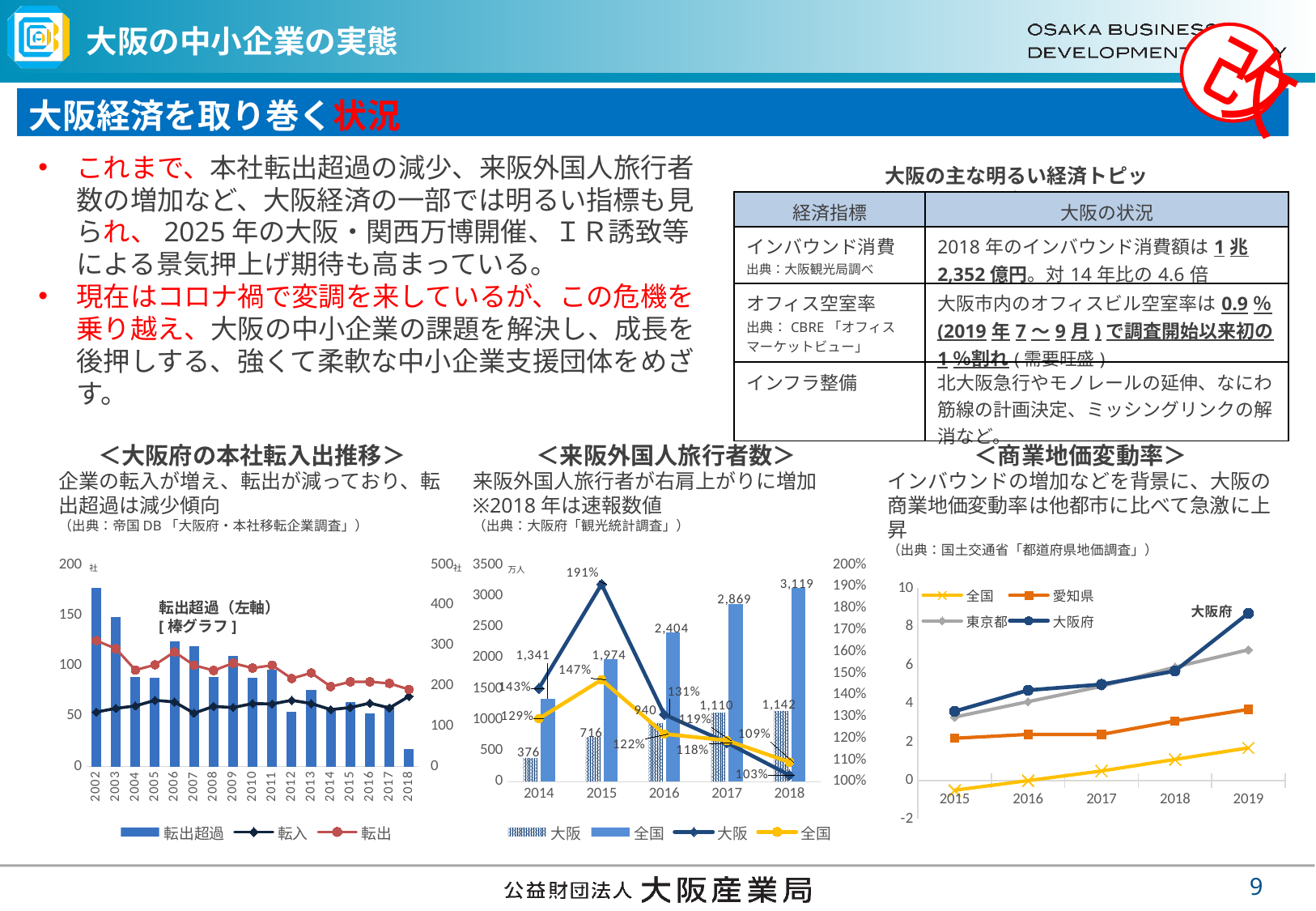
In the <来阪外国人旅行者数> chart, in which year does the 大阪 line reach its highest value? 2015 In the <来阪外国人旅行者数> chart, what is the value of the 大阪 bar for 2014? 376 In the <商業地価変動率> chart, is the value for 大阪府 in 2019 greater or less than 8? greater In the <来阪外国人旅行者数> chart, which is larger, the 大阪 bar for 2017 or for 2018? 2018 In the <来阪外国人旅行者数> chart, what is the difference between the 全国 bar values for 2018 and 2017? 250 How many series does the legend of the <商業地価変動率> chart list? 4 How many series does the legend of the <大阪府の本社転入出推移> chart list? 3 In the <大阪府の本社転入出推移> chart, which year has the highest 転出超過 bar? 2002 What kind of chart is the <商業地価変動率> chart on the right? line chart In the <来阪外国人旅行者数> chart, what is the value of the 全国 bar for 2018? 3,119 In the <来阪外国人旅行者数> chart, how many years are shown on the x axis? 5 In the <来阪外国人旅行者数> chart, do the 全国 bar values rise or fall from 2014 to 2018? rise